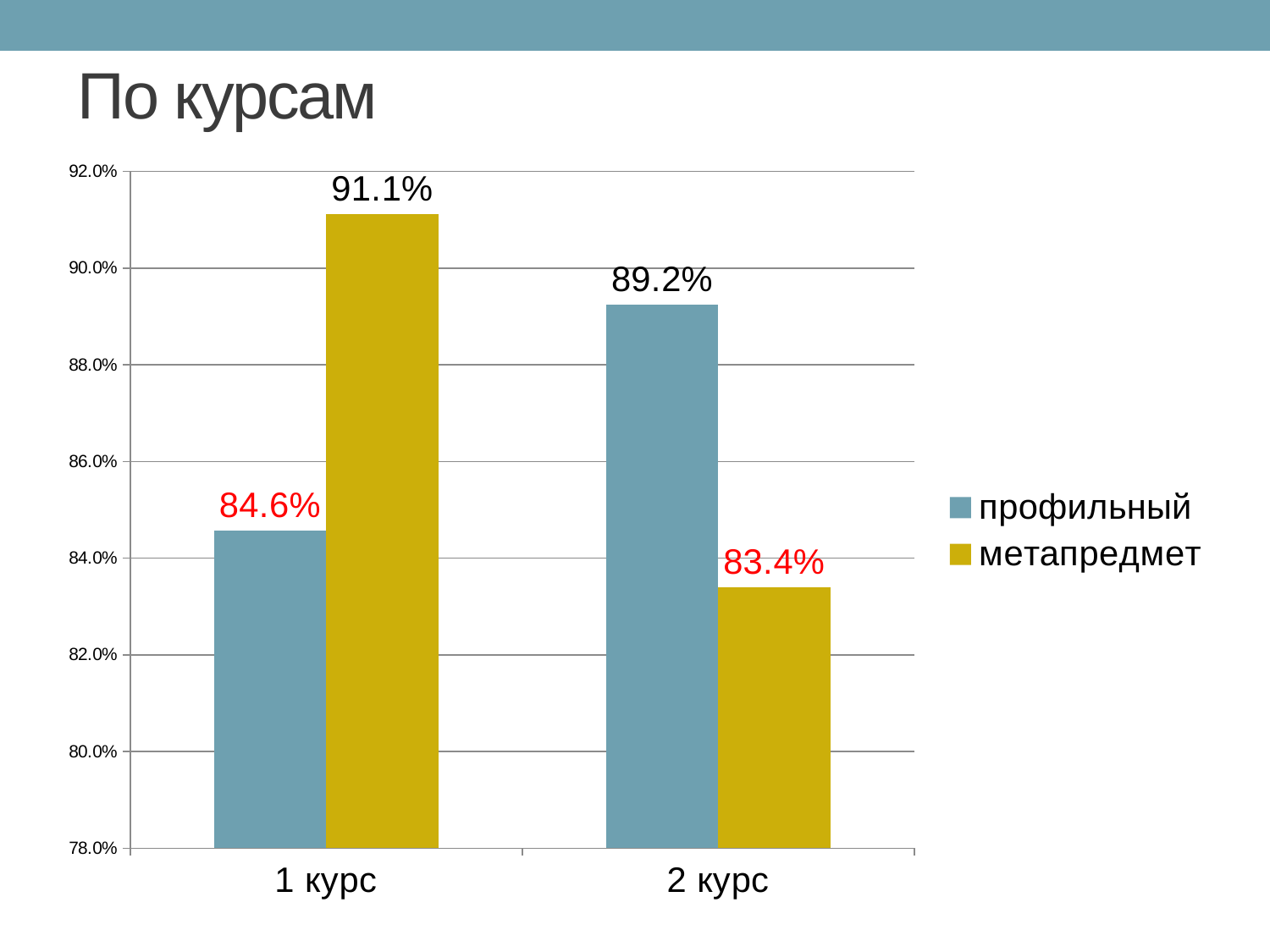
What kind of chart is shown on the slide? bar chart What is the value for метапредмет in 2 курс? 83.4% Which is larger in 2 курс, профильный or метапредмет? профильный What is the difference between профильный and метапредмет in 2 курс? 5.8% What is the value for метапредмет in 1 курс? 91.1% Which bar has the highest value on the chart? метапредмет, 1 курс What is the difference between метапредмет and профильный in 1 курс? 6.5% How many series does the legend list? 2 What is the value for профильный in 1 курс? 84.6% What is the title of the slide? По курсам Which bar has the lowest value on the chart? метапредмет, 2 курс What is the value for профильный in 2 курс? 89.2%